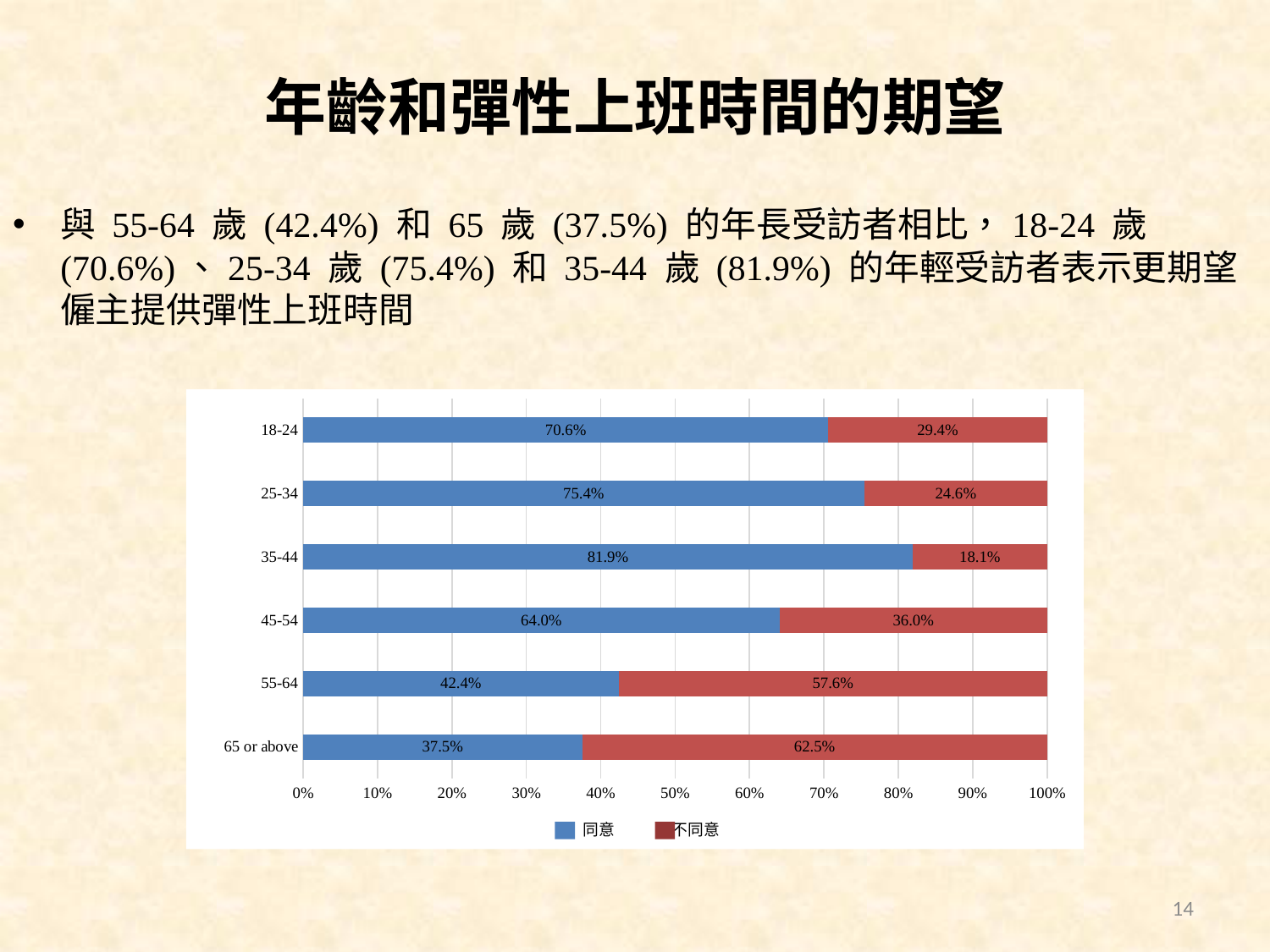
What is the 同意 value for the 35-44 age group? 81.9% Which is larger, the 不同意 value for 18-24 or for 25-34? 18-24 What is the 不同意 value for the 65 or above age group? 62.5% How many series does the legend list? 2 What is the total of the stacked bar for the 55-64 age group? 100.0% Which age group has the highest 同意 value? 35-44 What is the 同意 value for the 45-54 age group? 64.0% How many age groups are shown on the chart? 6 Which colour represents 不同意 in the chart? Red What is the difference between the 同意 values for 35-44 and 55-64? 39.5% Which age group has the lowest 同意 value? 65 or above What kind of chart is shown on the slide? Stacked bar chart